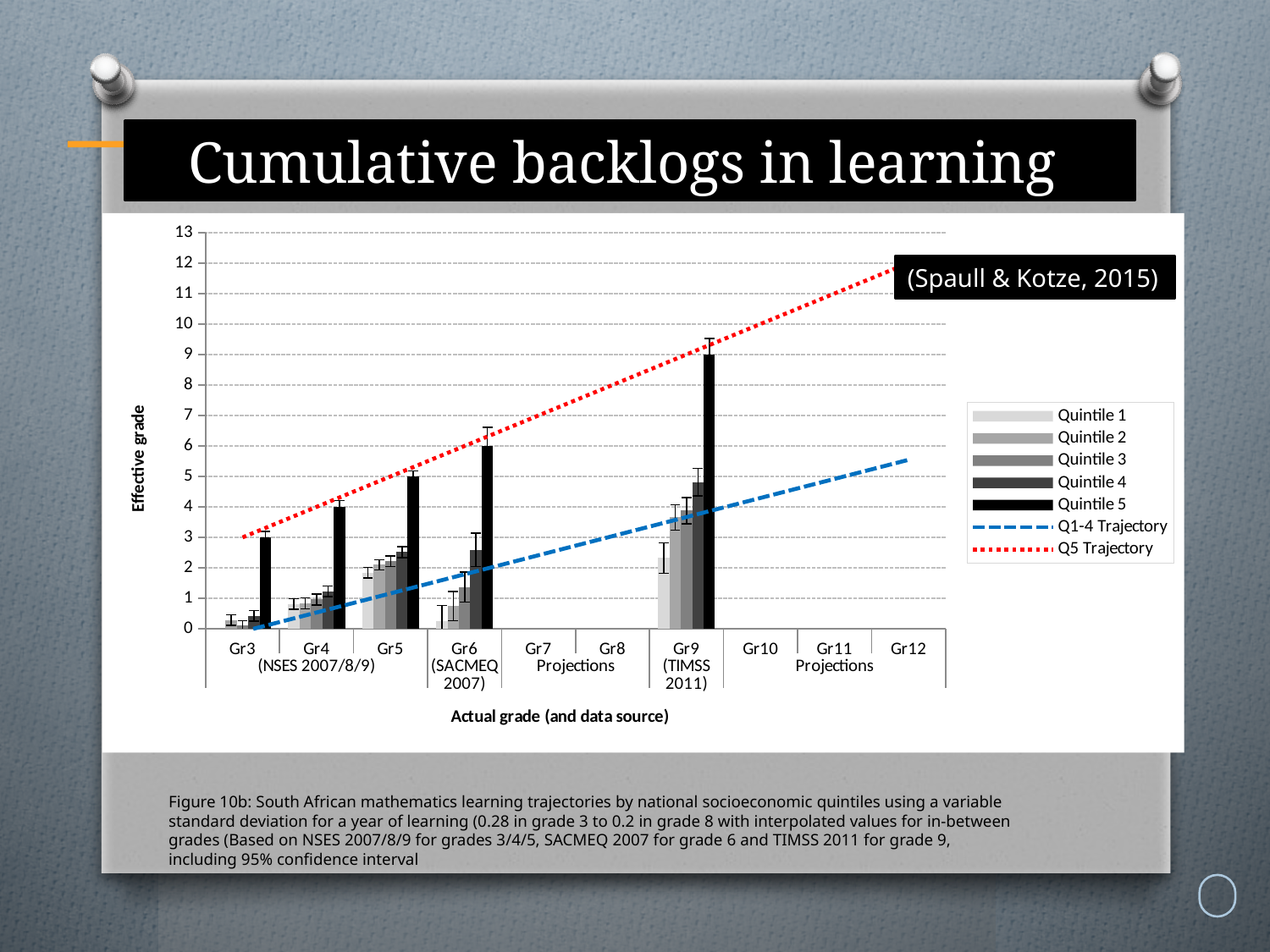
Is the effective grade for Quintile 1 at Gr9 greater or less than 3? less How many entries does the legend list? 7 Which is larger at Gr6: the Quintile 5 bar or the Quintile 4 bar? Quintile 5 What is the effective grade for Quintile 5 at Gr3? 3 What kind of chart is shown on the slide? bar and line chart What is the effective grade for Quintile 5 at Gr9? 9 How many grade categories are shown along the x axis? 10 Is the effective grade for Quintile 4 at Gr9 greater or less than 4? greater Do the Quintile 5 bars rise or fall from Gr3 to Gr9? rise What is the effective grade for Quintile 5 at Gr6? 6 Which quintile has the highest effective grade at Gr9? Quintile 5 What is the label of the y axis? Effective grade